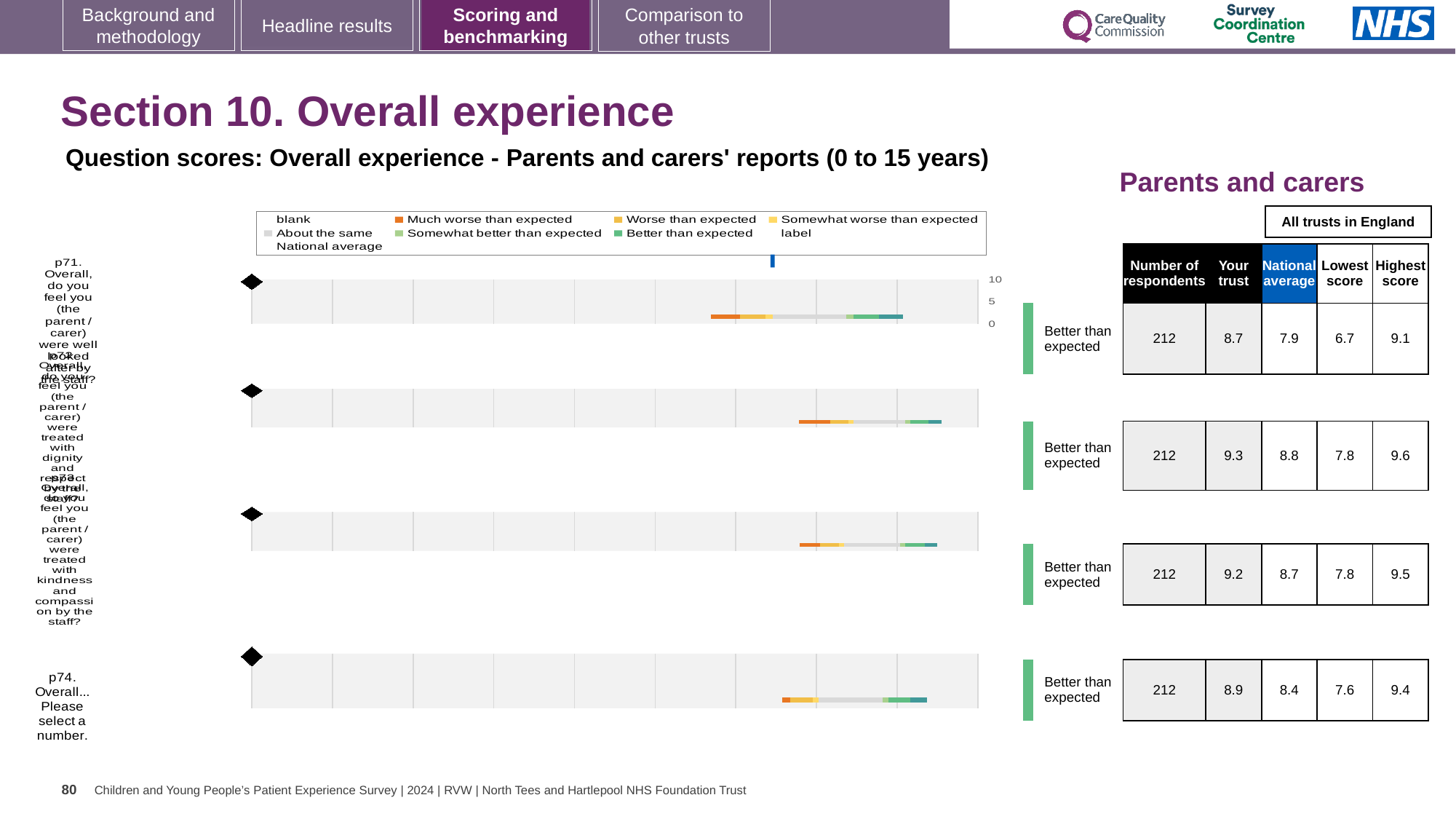
In the table beside the chart, what is the Highest score for the last row (p74)? 9.4 How many entries does the chart legend list? 9 What kind of chart is shown on the slide? bar chart What benchmark rating is shown next to each of the four question rows? Better than expected In the table beside the chart, which row has the highest 'Your trust' score? the second row (9.3) In the table beside the chart, what is the National average for the first row (p71)? 7.9 In the table beside the chart, for the last row (p74), which is larger: the 'Your trust' score or the National average? Your trust What is the label of the first (top) question row in the chart? p71. Overall, do you feel you (the parent / carer) were well looked after by the staff? In the table beside the chart, what is the 'Your trust' score for the first row (p71)? 8.7 How many question rows (bars) does the chart show? 4 In the table beside the chart, what is the number of respondents for the last row (p74)? 212 In the table beside the chart, what is the difference between the 'Your trust' score and the National average for the first row (p71)? 0.8